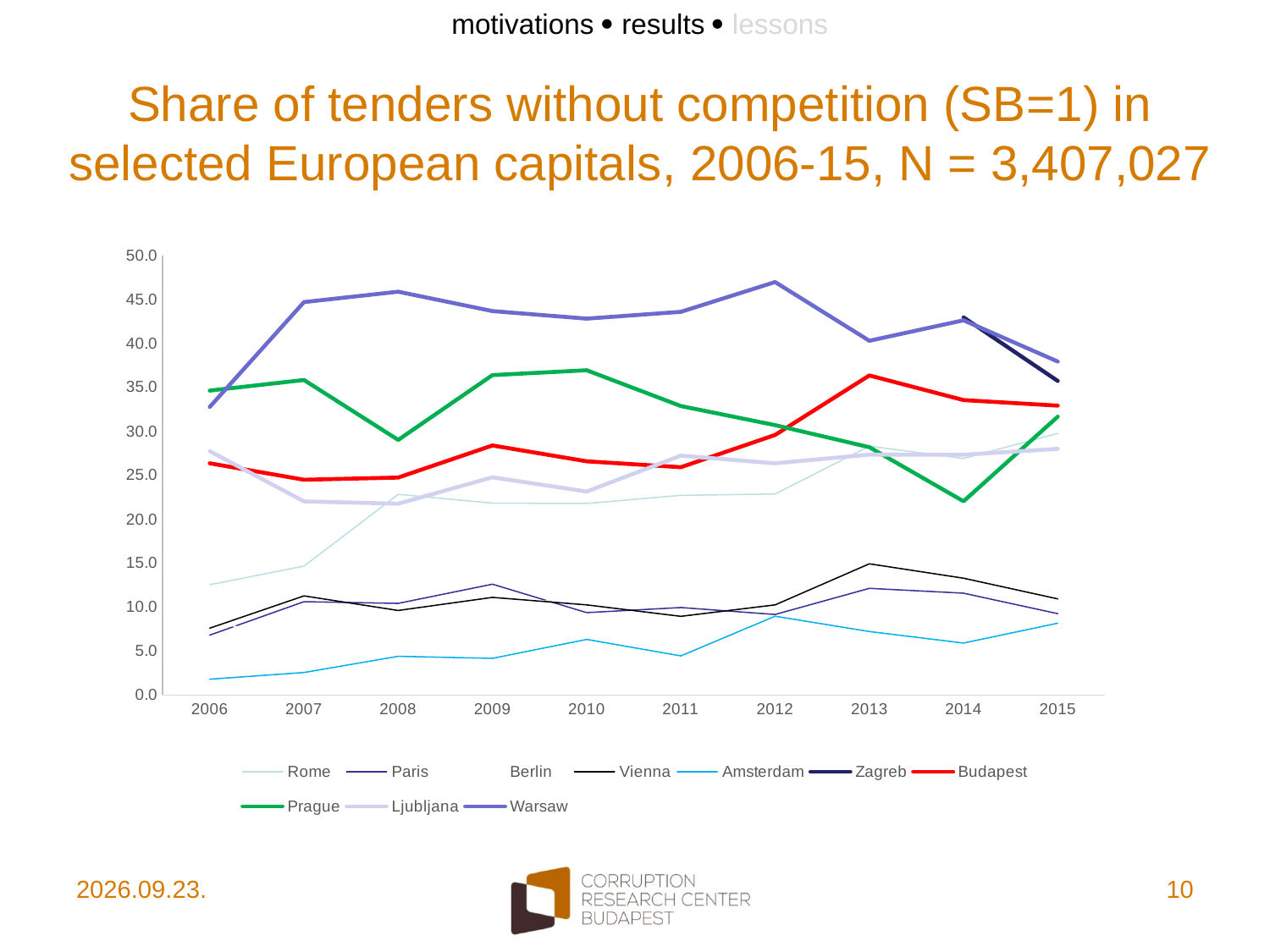
Which city has the lowest share of tenders without competition in 2006? Amsterdam In 2013, which is larger: the value for Budapest or the value for Prague? Budapest How many years are shown on the x axis? 10 Is the value for Warsaw in 2008 greater or less than 40.0? greater What is the title of the chart? Share of tenders without competition (SB=1) in selected European capitals, 2006-15, N = 3,407,027 How many series does the legend list? 10 Is the value for Amsterdam in 2015 greater or less than 10.0? less Which city has the highest share of tenders without competition in 2012? Warsaw Does the value for Amsterdam rise or fall from 2006 to 2012? rise What kind of chart is shown on the slide? line chart Is the value for Prague in 2014 greater or less than 25.0? less